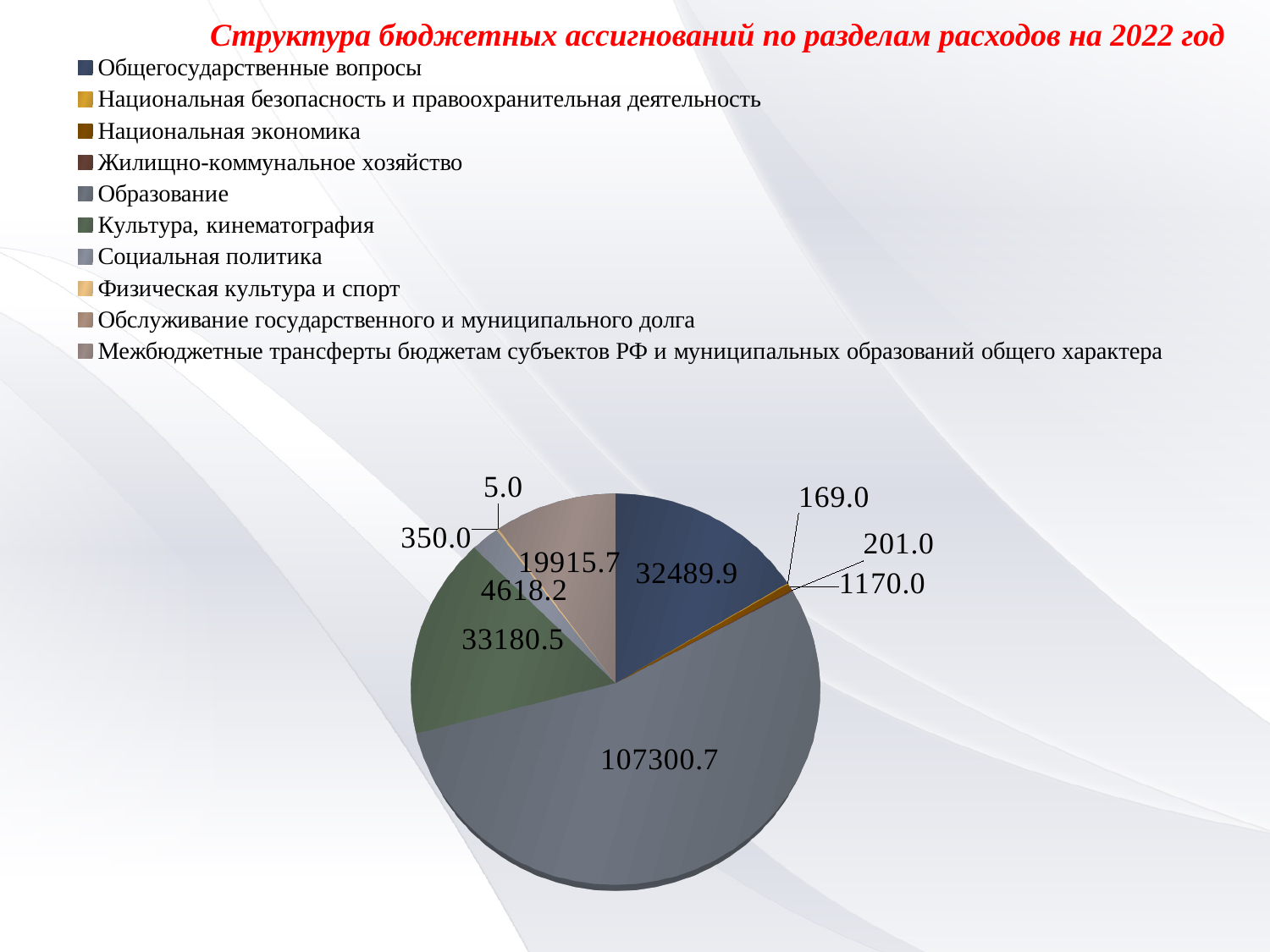
What kind of chart is shown on the slide? pie chart What is the difference between the values for Культура, кинематография and Общегосударственные вопросы? 690.6 What is the value for Культура, кинематография? 33180.5 How many data labels are shown on the pie chart? 10 What is the value for Жилищно-коммунальное хозяйство? 201.0 What is the title of the chart? Структура бюджетных ассигнований по разделам расходов на 2022 год How many categories does the legend list? 10 Which category has the largest slice of the pie? Образование What is the value for Общегосударственные вопросы? 32489.9 What is the value for Образование? 107300.7 Which is larger, the value for Образование or the value for Культура, кинематография? Образование What is the smallest value labelled on the pie chart? 5.0